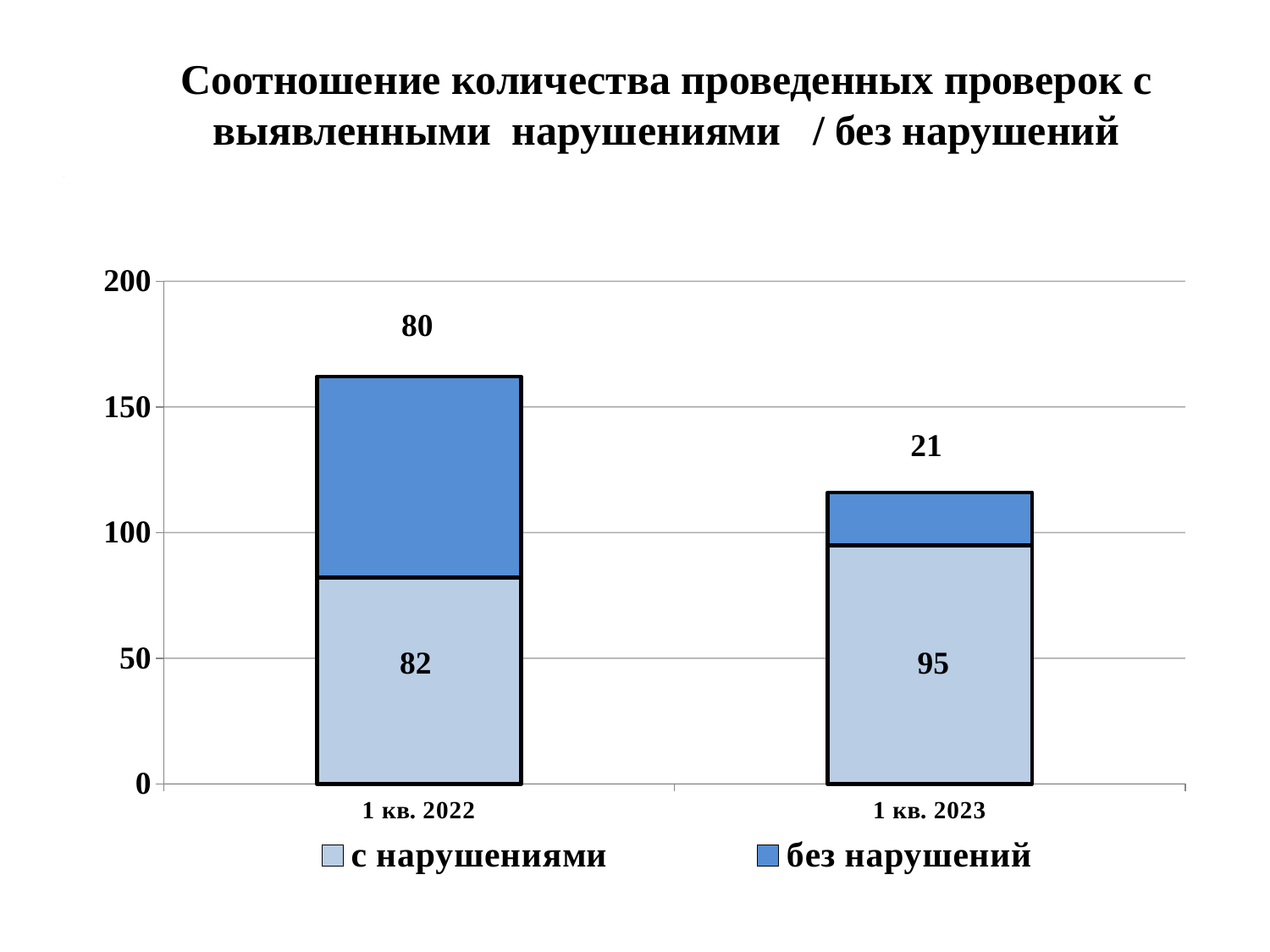
What is the total of the stacked bar for 1 кв. 2023? 116 What is the difference between the "без нарушений" values for 1 кв. 2022 and 1 кв. 2023? 59 How many categories are shown on the x axis? 2 Which period has the higher value for "с нарушениями"? 1 кв. 2023 What kind of chart is shown on the slide? Stacked bar chart How many series does the legend list? 2 What is the value for "без нарушений" in 1 кв. 2023? 21 What is the value for "без нарушений" in 1 кв. 2022? 80 What is the value for "с нарушениями" in 1 кв. 2023? 95 What is the total of the stacked bar for 1 кв. 2022? 162 Which period has the lower value for "без нарушений"? 1 кв. 2023 What is the value for "с нарушениями" in 1 кв. 2022? 82